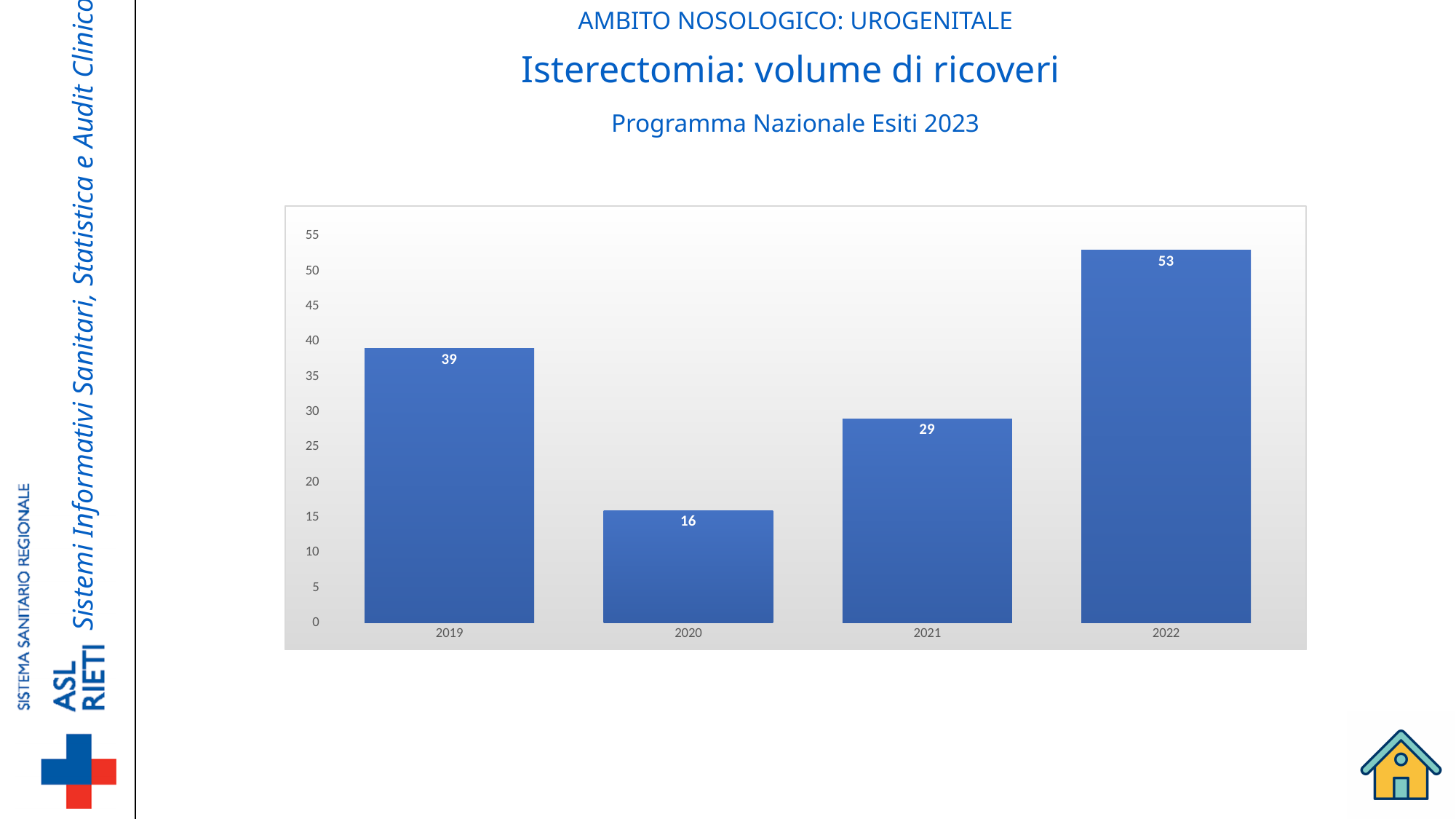
Which is larger, the value for 2021 or the value for 2019? 2019 What is the value for 2022? 53 What is the value for 2021? 29 How many years are shown on the x axis? 4 Is the value for 2021 greater or less than 25? greater What is the value for 2019? 39 Which year has the lowest value? 2020 What is the main title of the slide above the chart? Isterectomia: volume di ricoveri What is the difference between the values for 2022 and 2019? 14 Which year has the highest value? 2022 What is the value for 2020? 16 What kind of chart is shown on the slide? Bar chart